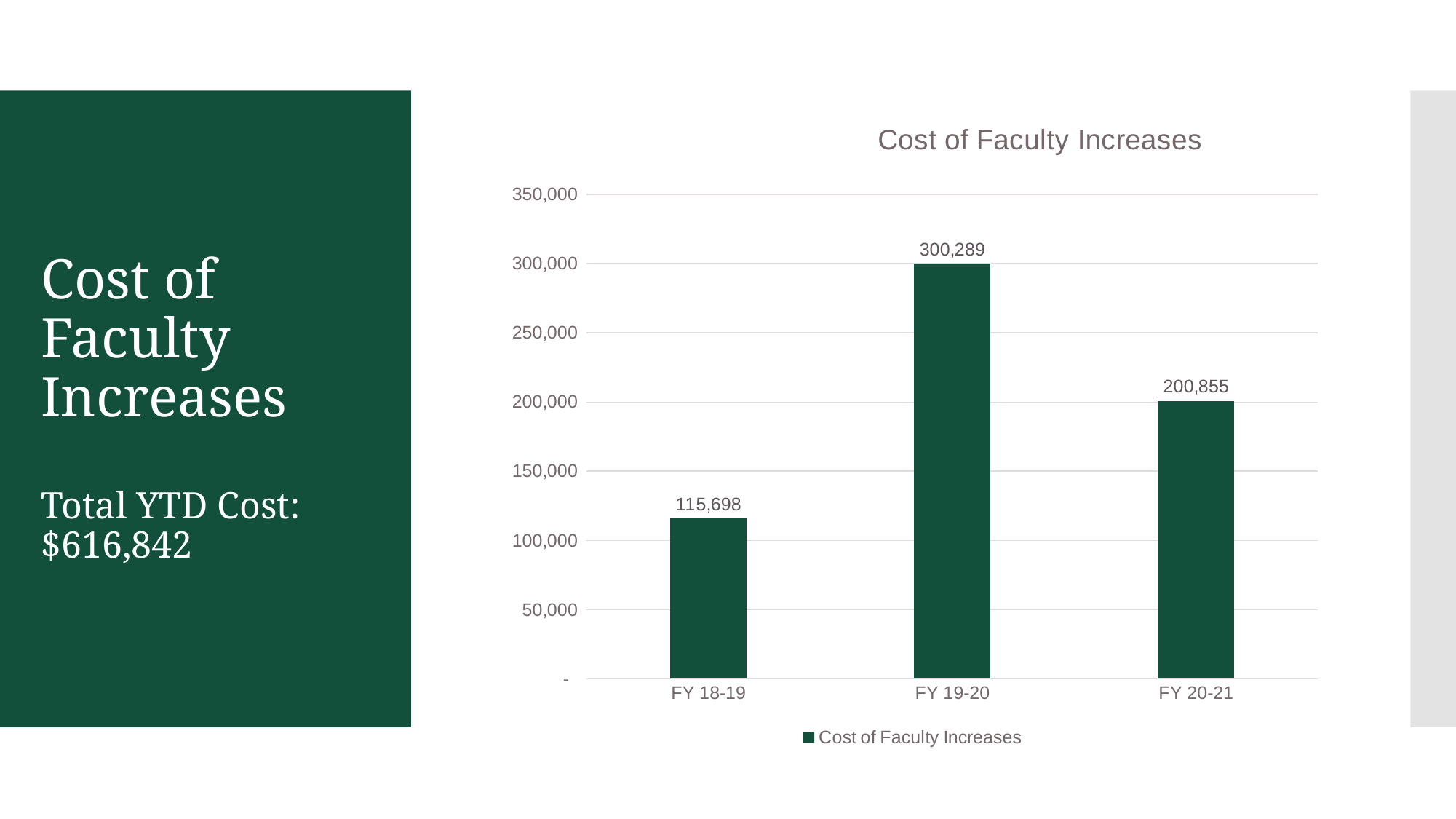
What is the value for FY 19-20 in the Cost of Faculty Increases chart? 300,289 Is the value for FY 18-19 greater or less than 150,000? less Which is larger, the value for FY 18-19 or the value for FY 20-21? FY 20-21 How many fiscal years are shown in the chart? 3 What is the difference between the values for FY 19-20 and FY 20-21? 99,434 What is the value for FY 18-19 in the Cost of Faculty Increases chart? 115,698 What is the difference between the values for FY 20-21 and FY 18-19? 85,157 How many series does the chart legend list? 1 What kind of chart is shown on the slide? bar chart Which fiscal year has the lowest cost of faculty increases? FY 18-19 What is the value for FY 20-21 in the Cost of Faculty Increases chart? 200,855 Which fiscal year has the highest cost of faculty increases? FY 19-20